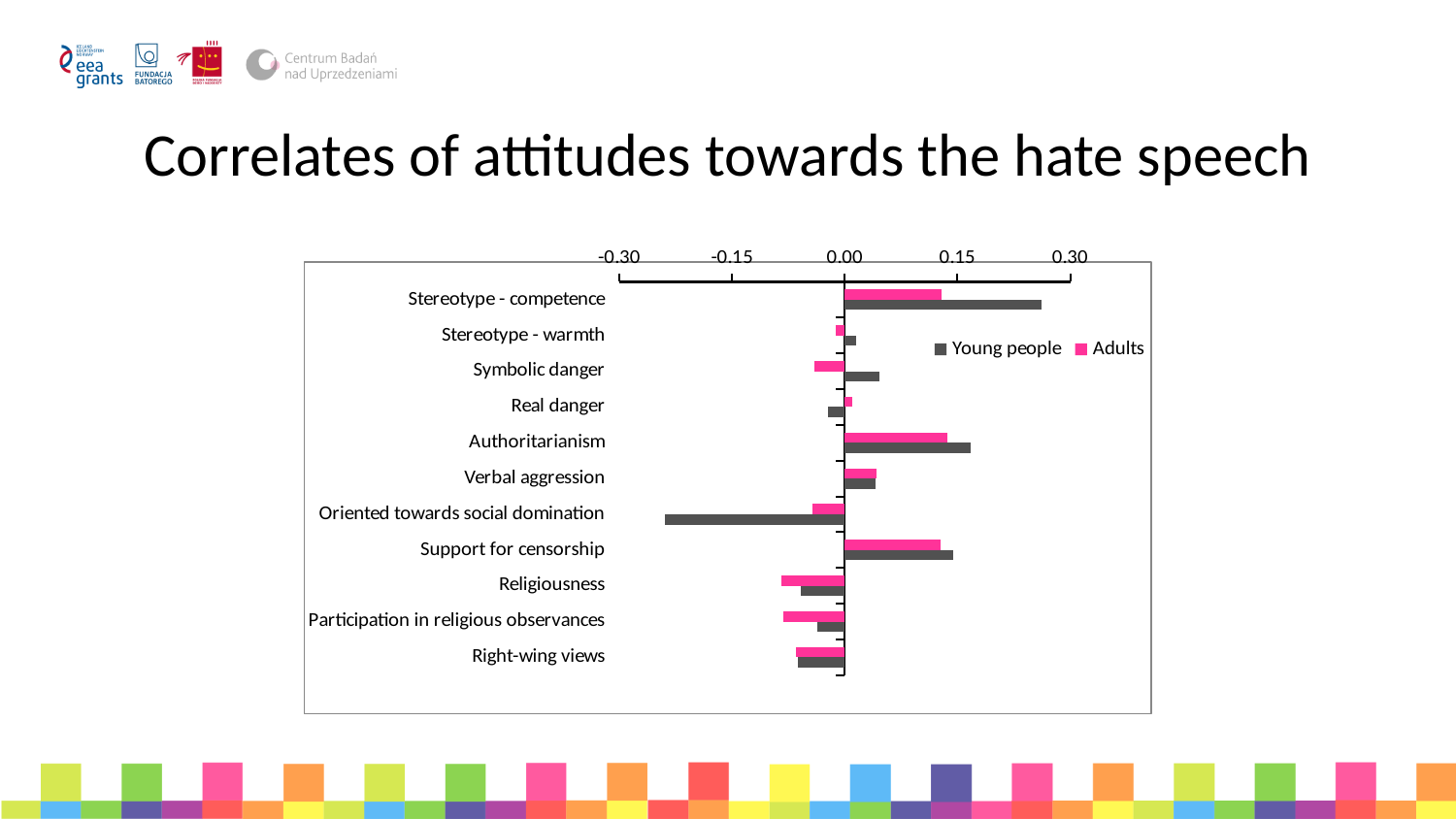
Is the Young people value for Oriented towards social domination greater or less than -0.15? less How many categories are plotted on the chart? 11 Is the Young people value for Stereotype - competence greater or less than 0.15? greater Which category has the highest value for Young people? Stereotype - competence What is the title of the chart on the slide? Correlates of attitudes towards the hate speech Which category has the lowest value for Young people? Oriented towards social domination For Stereotype - competence, which series has the larger value, Young people or Adults? Young people What kind of chart is shown on the slide? Bar chart Is the Adults value for Religiousness greater or less than 0.00? less How many series does the legend list? 2 For Oriented towards social domination, which series has the lower value, Young people or Adults? Young people